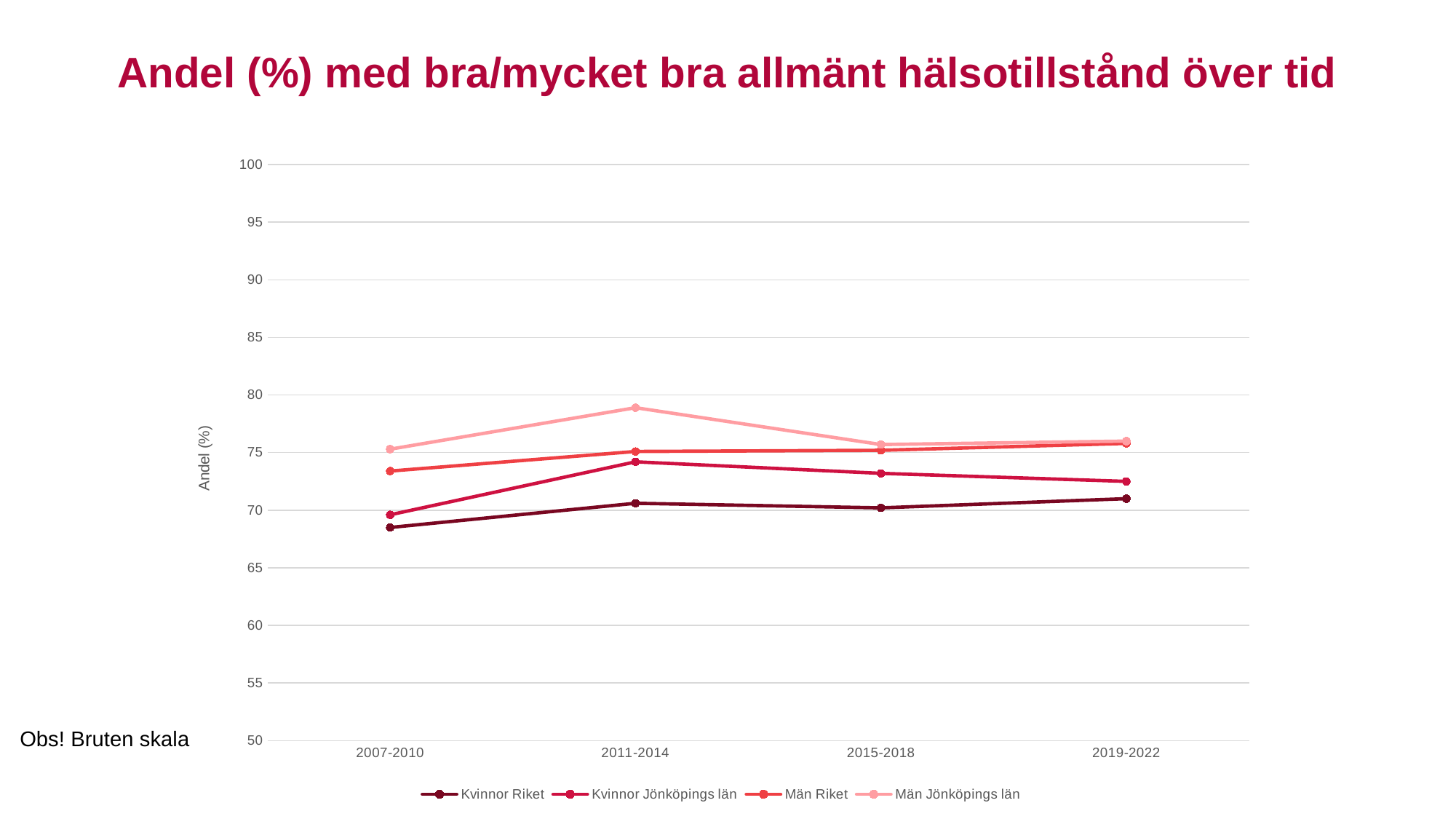
How many time periods are shown on the x axis? 4 How many series does the legend list? 4 In which period does Män Jönköpings län reach its highest value? 2011-2014 Is the value for Män Jönköpings län in 2011-2014 greater or less than 80? less In 2011-2014, which is larger: Kvinnor Jönköpings län or Kvinnor Riket? Kvinnor Jönköpings län What kind of chart is shown on the slide? line chart Does the value for Kvinnor Jönköpings län rise or fall from 2011-2014 to 2019-2022? fall Is the value for Kvinnor Riket in 2007-2010 greater or less than 70? less Which series has the highest value in 2011-2014? Män Jönköpings län What is the label on the y axis? Andel (%) Which series has the lowest value in 2007-2010? Kvinnor Riket Is the value for Kvinnor Jönköpings län in 2011-2014 greater or less than 70? greater